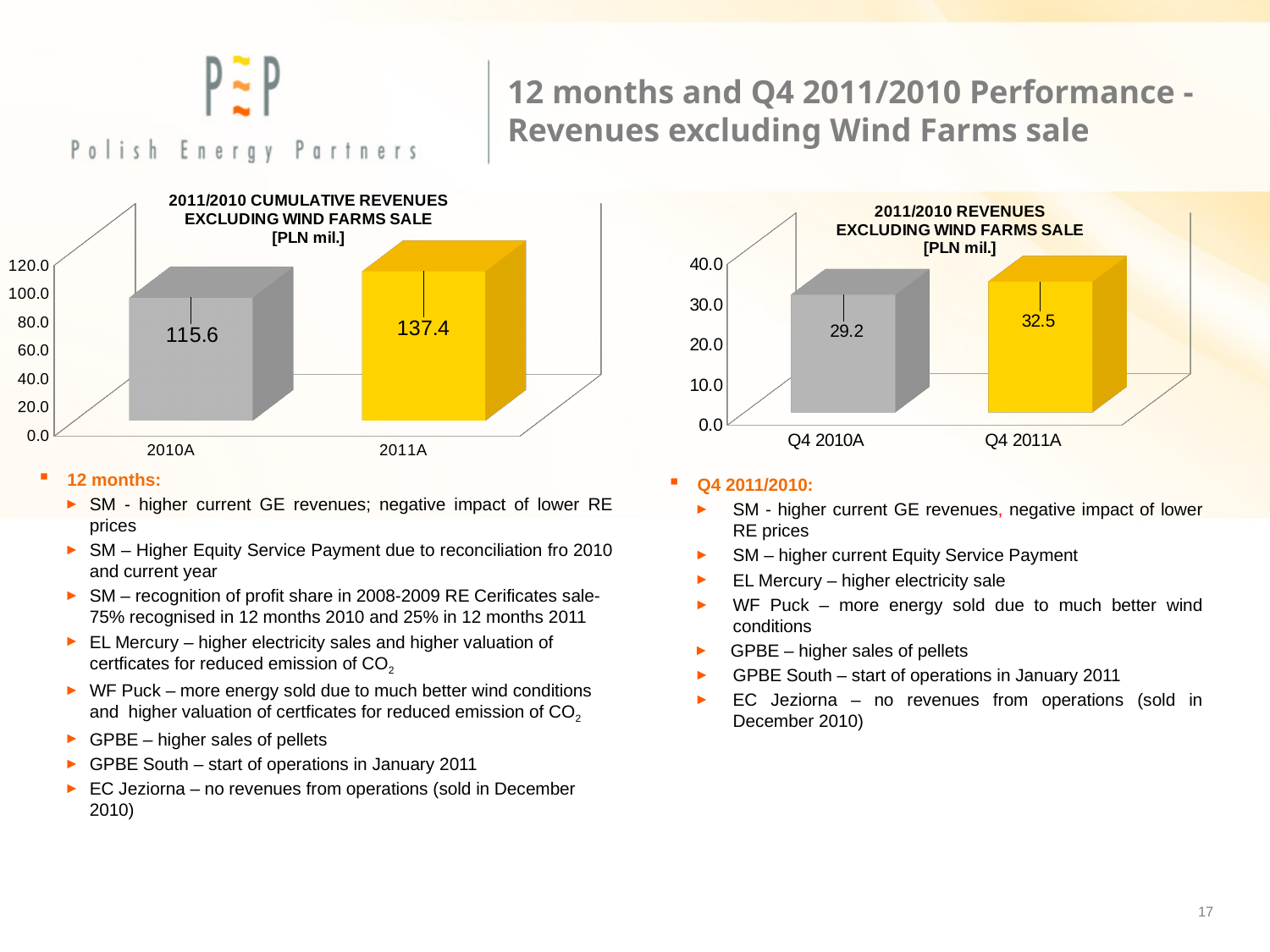
In the left chart (2011/2010 Cumulative Revenues Excluding Wind Farms Sale), what unit is given in the chart title? PLN mil. In the left chart (2011/2010 Cumulative Revenues Excluding Wind Farms Sale), what is the value for 2011A? 137.4 In the left chart (2011/2010 Cumulative Revenues Excluding Wind Farms Sale), which category has the higher value? 2011A In the left chart (2011/2010 Cumulative Revenues Excluding Wind Farms Sale), how many categories are shown on the x axis? 2 In the left chart (2011/2010 Cumulative Revenues Excluding Wind Farms Sale), what is the difference between the 2011A and 2010A values? 21.8 In the left chart (2011/2010 Cumulative Revenues Excluding Wind Farms Sale), what is the value for 2010A? 115.6 In the right chart (2011/2010 Revenues Excluding Wind Farms Sale), what is the value for Q4 2010A? 29.2 In the right chart (2011/2010 Revenues Excluding Wind Farms Sale), is the value for Q4 2011A greater or less than 30.0? greater What kind of chart is the left chart (2011/2010 Cumulative Revenues Excluding Wind Farms Sale)? bar chart In the right chart (2011/2010 Revenues Excluding Wind Farms Sale), which category has the lower value? Q4 2010A In the right chart (2011/2010 Revenues Excluding Wind Farms Sale), what is the value for Q4 2011A? 32.5 In the right chart (2011/2010 Revenues Excluding Wind Farms Sale), what is the difference between the Q4 2011A and Q4 2010A values? 3.3